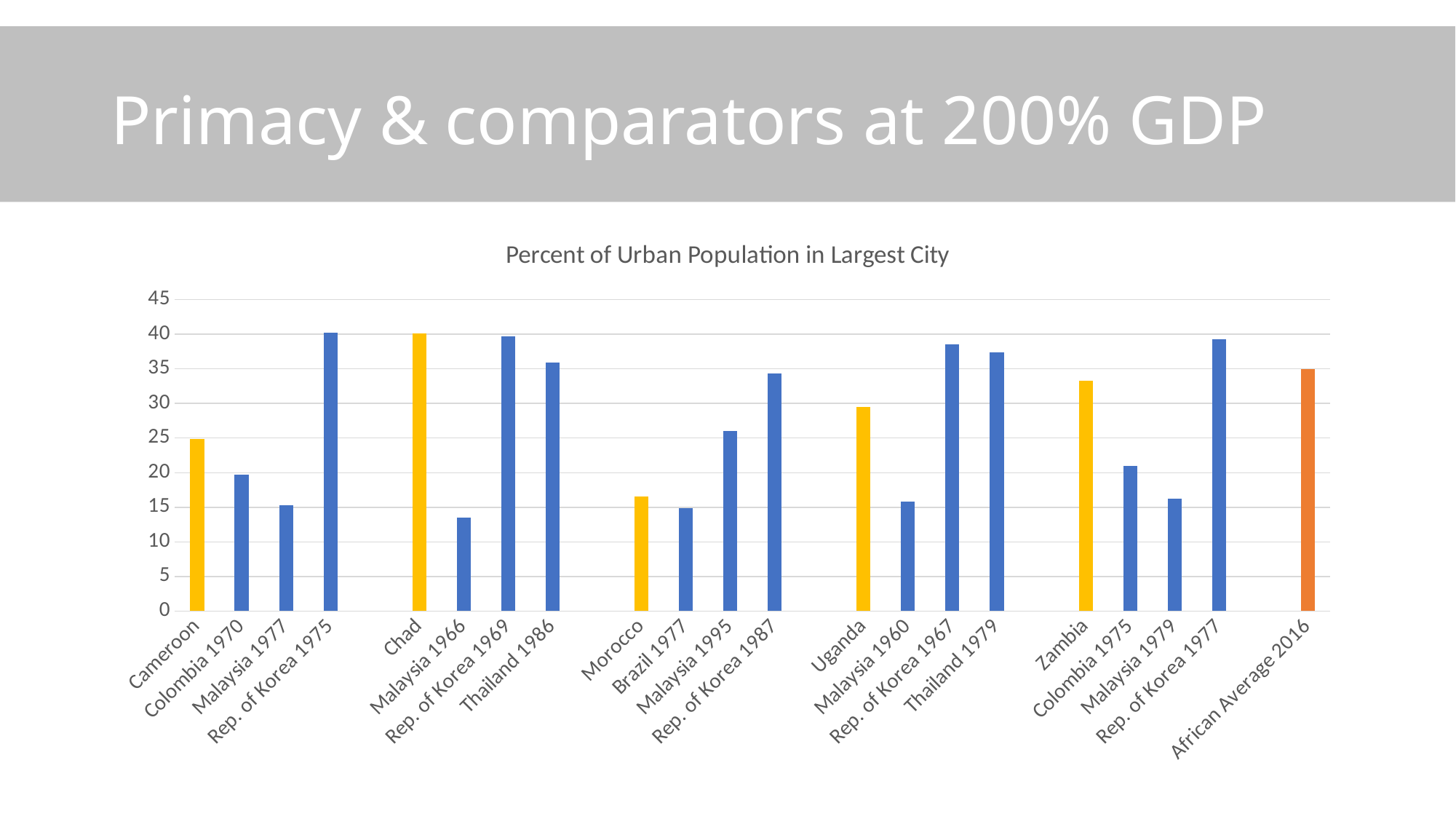
Is the value for African Average 2016 greater or less than 40? less Is the value for Zambia greater or less than 30? greater Is the value for Malaysia 1966 greater or less than 15? less What is the title of the chart? Percent of Urban Population in Largest City Which has a higher value, Malaysia 1995 or Malaysia 1960? Malaysia 1995 Which has a higher value, Chad or Cameroon? Chad How many bars (categories) are plotted in the chart? 21 Which has a higher value, Zambia or Uganda? Zambia What kind of chart is shown on the slide? bar chart